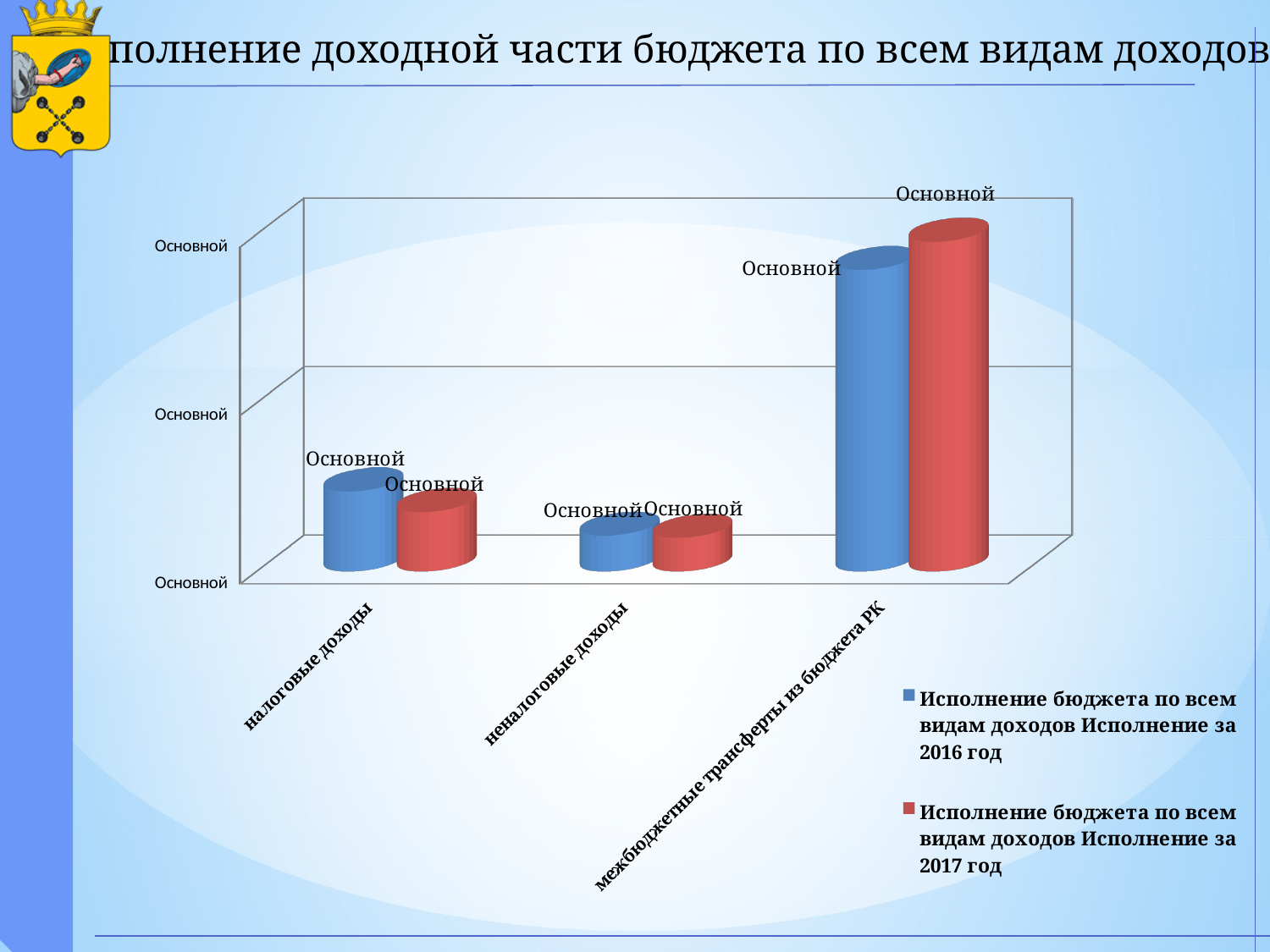
What colour are the bars for the series Исполнение за 2017 год? Red For межбюджетные трансферты из бюджета РК, which is larger: the value for Исполнение за 2016 год or for Исполнение за 2017 год? Исполнение за 2017 год How many series does the chart's legend list? 2 Which category has the shortest bars in the chart? неналоговые доходы Which category has the tallest bars in the chart? межбюджетные трансферты из бюджета РК For налоговые доходы, which is larger: the value for Исполнение за 2016 год or for Исполнение за 2017 год? Исполнение за 2016 год How many categories are shown on the x axis of the chart? 3 What colour are the bars for the series Исполнение за 2016 год? Blue Which is larger: the 2017 value for межбюджетные трансферты из бюджета РК or the 2017 value for налоговые доходы? межбюджетные трансферты из бюджета РК What kind of chart is shown on the slide? Bar chart